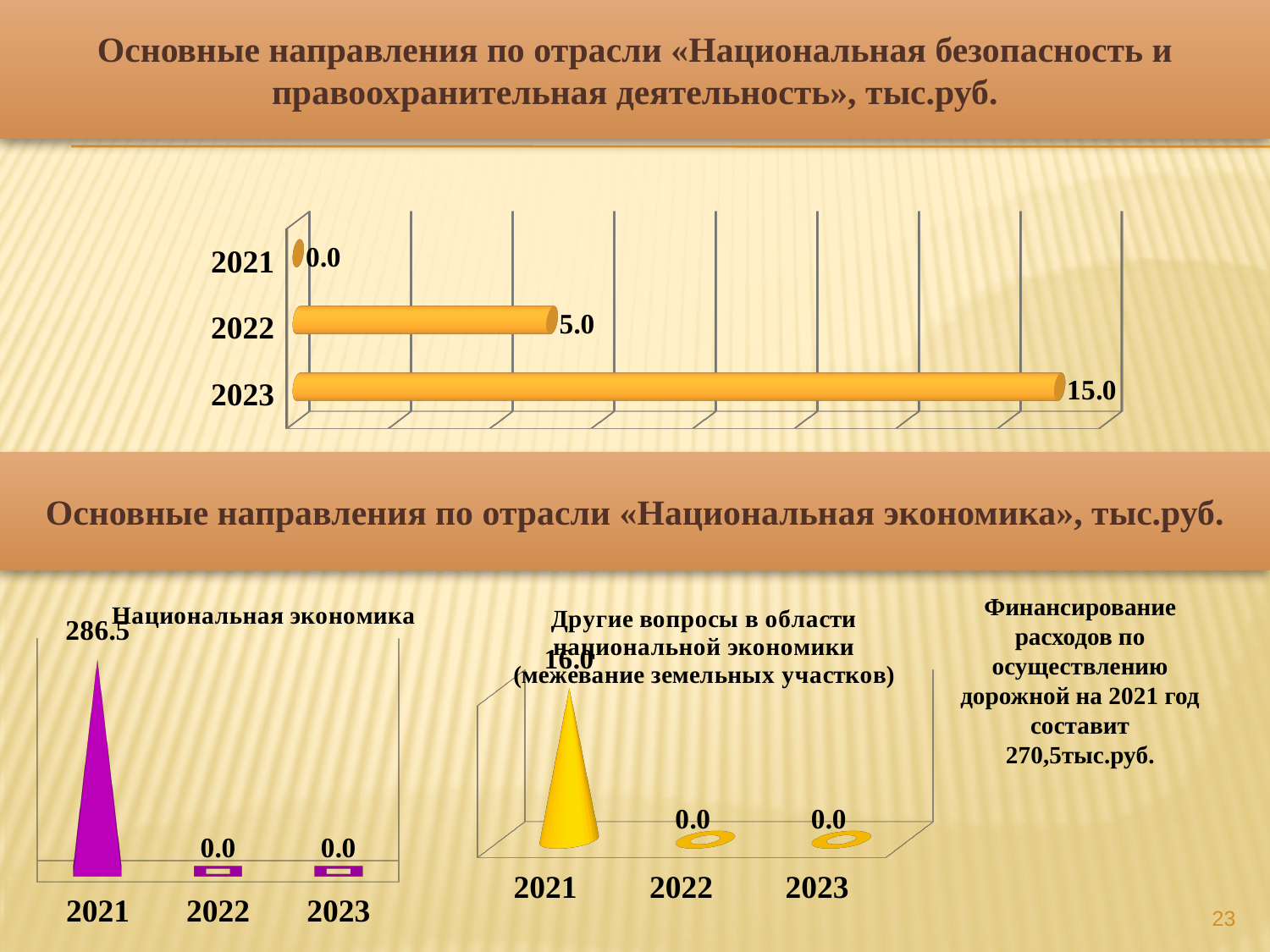
In the top chart «Национальная безопасность и правоохранительная деятельность», do the values rise or fall from 2021 to 2023? rise In the bottom-left chart «Национальная экономика», what is the value for 2023? 0.0 In the bottom-left chart «Национальная экономика», what is the value for 2021? 286.5 In the top chart «Национальная безопасность и правоохранительная деятельность», what is the difference between the 2023 and 2022 values? 10.0 In the top chart «Национальная безопасность и правоохранительная деятельность», which year has the highest value? 2023 In the bottom-middle chart «Другие вопросы в области национальной экономики (межевание земельных участков)», what is the value for 2021? 16.0 In the top chart «Национальная безопасность и правоохранительная деятельность», what is the value for 2023? 15.0 In the bottom-middle chart «Другие вопросы в области национальной экономики (межевание земельных участков)», how many years are shown? 3 Which is larger: the 2021 value in the bottom-left chart «Национальная экономика» or the 2021 value in the bottom-middle chart «Другие вопросы в области национальной экономики»? Национальная экономика (286.5) In the top chart «Национальная безопасность и правоохранительная деятельность», what is the value for 2022? 5.0 In the top chart «Национальная безопасность и правоохранительная деятельность», which year has the lowest value? 2021 What kind of chart is the top chart «Национальная безопасность и правоохранительная деятельность»? bar chart